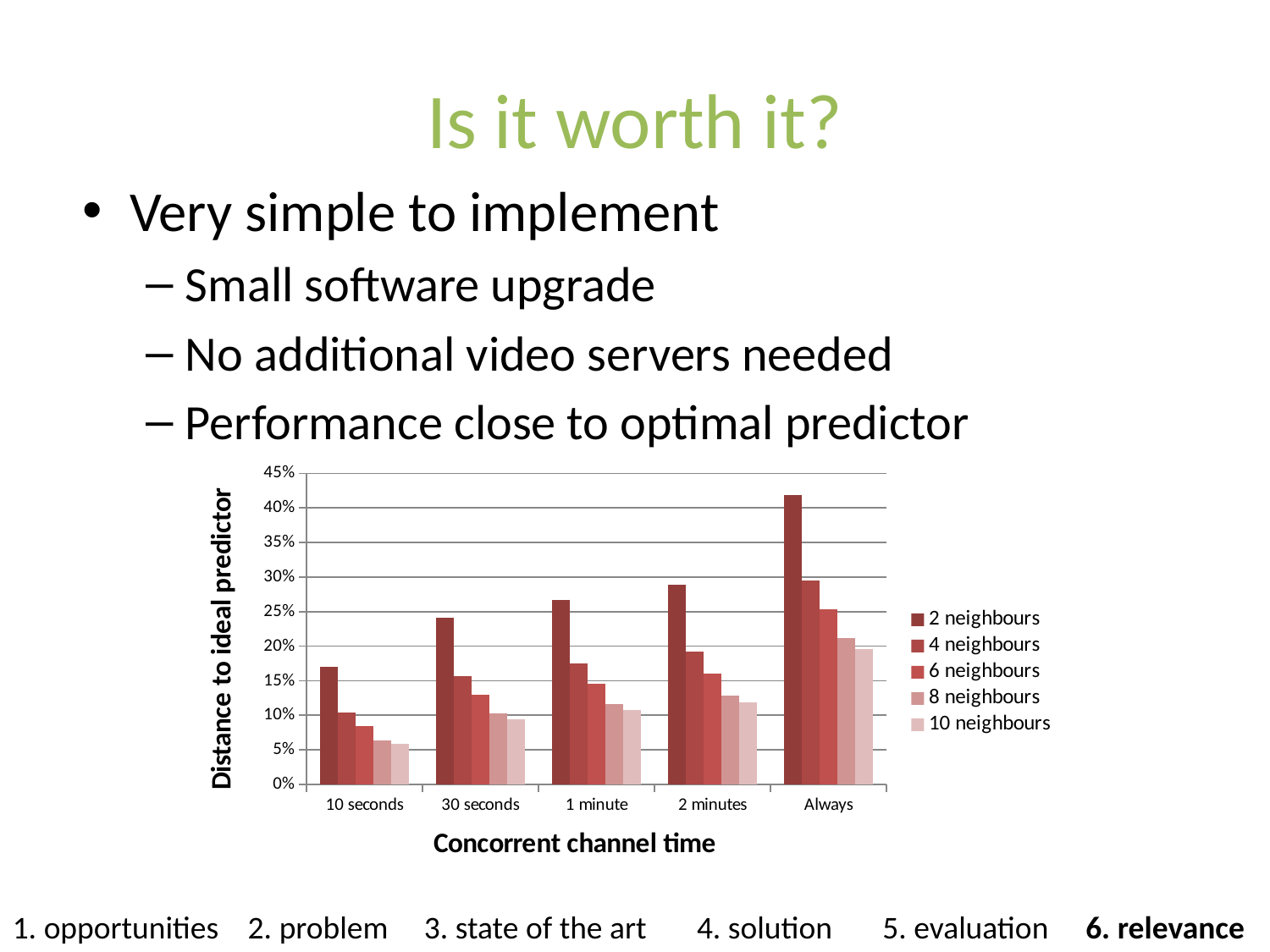
How many concurrent channel time categories are shown on the x axis? 5 Is the value for 2 neighbours at Always greater or less than 40%? greater What is the title of the y axis? Distance to ideal predictor For the 2 neighbours series, which concurrent channel time has the lowest distance to ideal predictor? 10 seconds What is the title of the x axis? Concorrent channel time For the 2 neighbours series, which concurrent channel time has the highest distance to ideal predictor? Always What kind of chart is shown on the slide? bar chart Does the distance to ideal predictor for 2 neighbours rise or fall as concurrent channel time increases from 10 seconds to Always? rise Is the value for 10 neighbours at 10 seconds greater or less than 10%? less Within the Always category, which series has the larger value: 2 neighbours or 10 neighbours? 2 neighbours How many series does the legend list? 5 Is the value for 2 neighbours at 30 seconds greater or less than 20%? greater